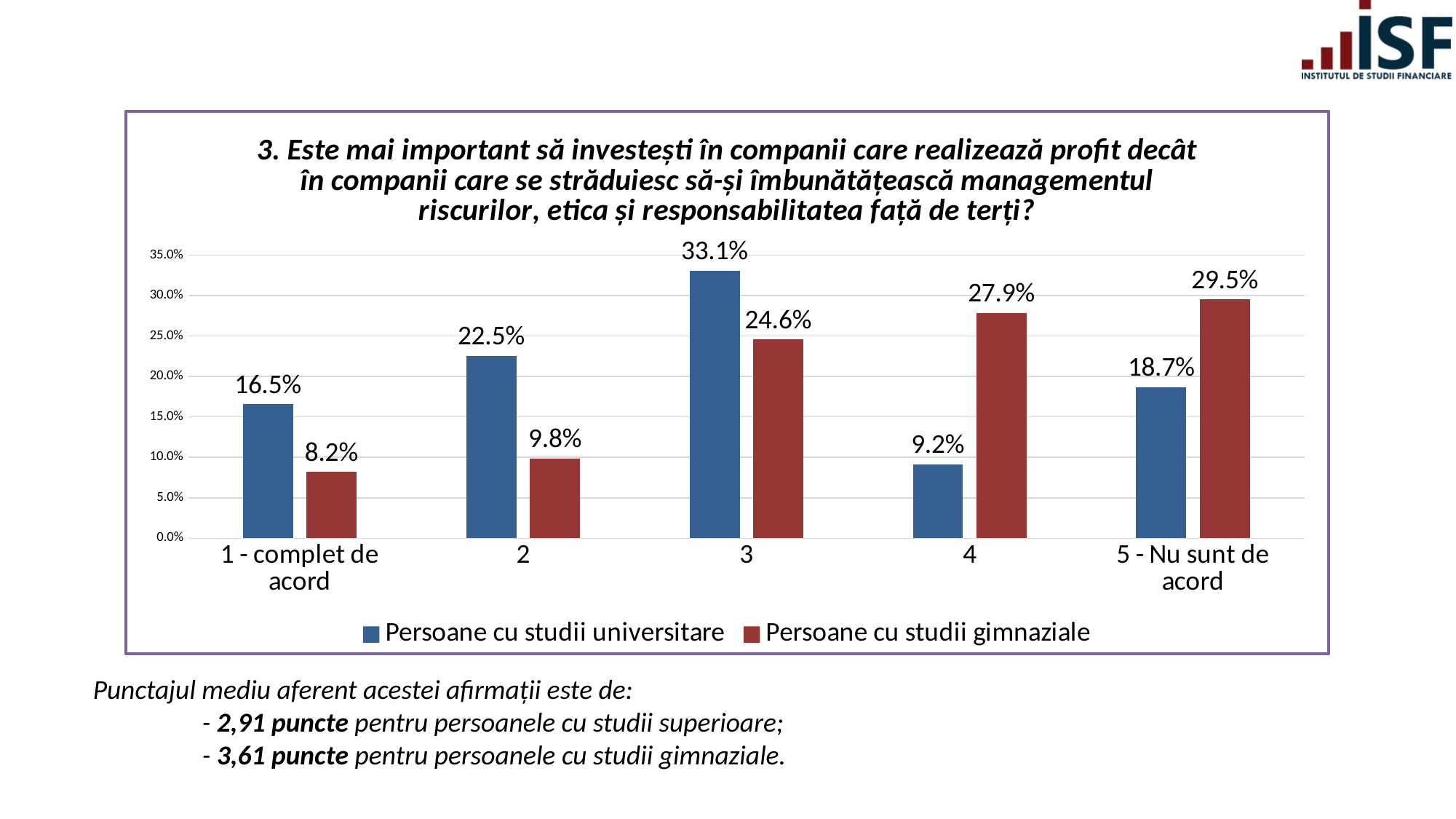
Which category has the highest value for 'Persoane cu studii universitare'? 3 Is the value for 'Persoane cu studii gimnaziale' at category 3 greater or less than 25.0%? less How many categories are shown on the x axis? 5 What is the value for 'Persoane cu studii gimnaziale' at '1 - complet de acord'? 8.2% How many series does the legend list? 2 At category 2, which series has the larger value? Persoane cu studii universitare What is the value for 'Persoane cu studii universitare' at category 3? 33.1% Which colour represents 'Persoane cu studii gimnaziale'? red What kind of chart is shown? bar chart Which category has the lowest value for 'Persoane cu studii gimnaziale'? 1 - complet de acord What is the difference between the two series at category 4? 18.7% What is the value for 'Persoane cu studii gimnaziale' at '5 - Nu sunt de acord'? 29.5%